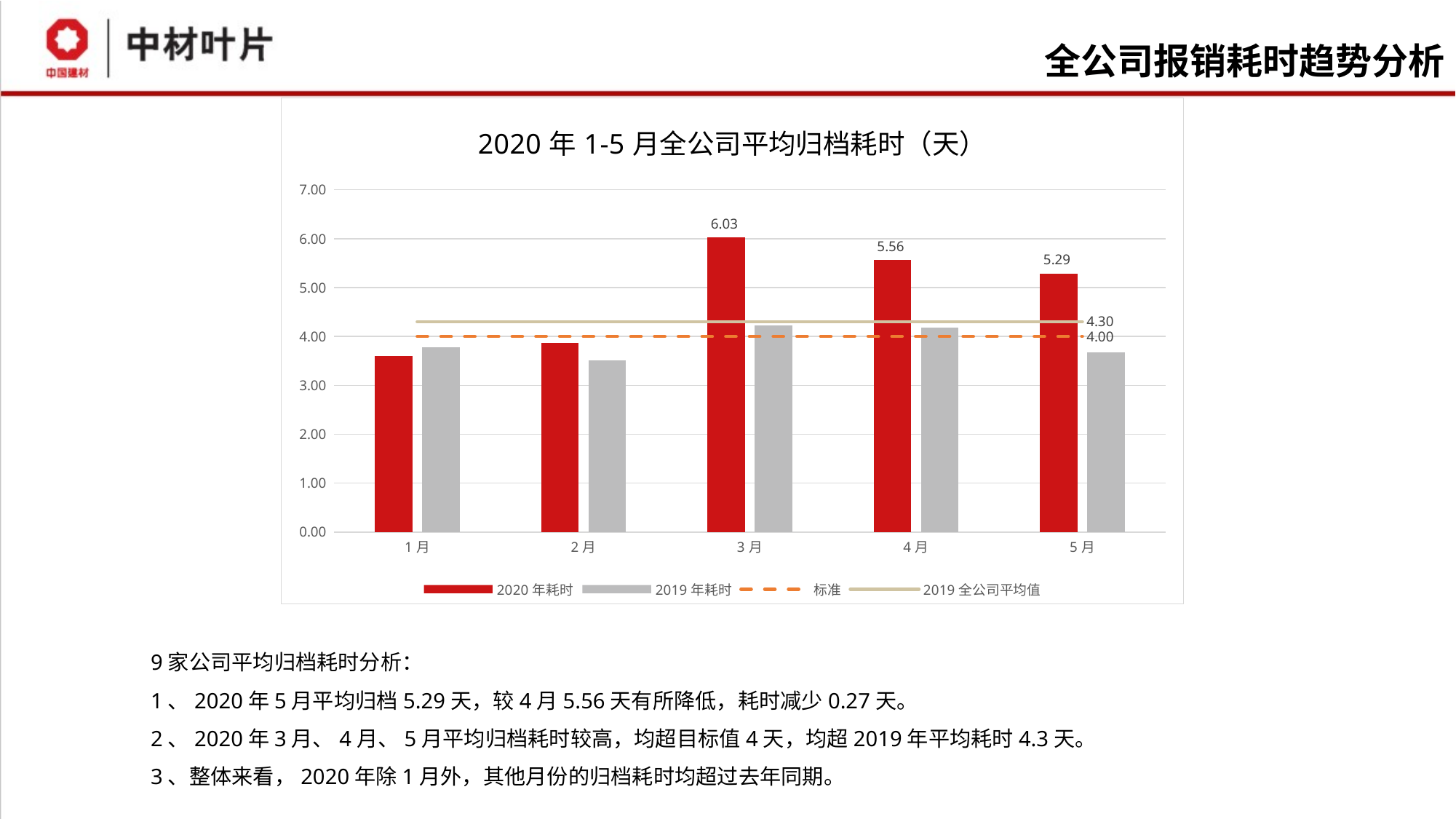
Is the 2019 年耗时 value for 2 月 greater or less than 4.00? less What is the difference between the 2020 年耗时 values for 4 月 and 5 月? 0.27 What is the 2020 年耗时 value for 4 月? 5.56 How many series does the legend list? 4 Which month has the lowest 2020 年耗时 value? 1 月 Is the 2020 年耗时 value for 1 月 greater or less than 4.00? less What is the 2020 年耗时 value for 3 月? 6.03 How many months are shown on the x axis? 5 For 3 月, which is larger: the 2020 年耗时 value or the 2019 年耗时 value? 2020 年耗时 What is the 2020 年耗时 value for 5 月? 5.29 Which month has the highest 2020 年耗时 value? 3 月 What value does the 标准 line sit at? 4.00